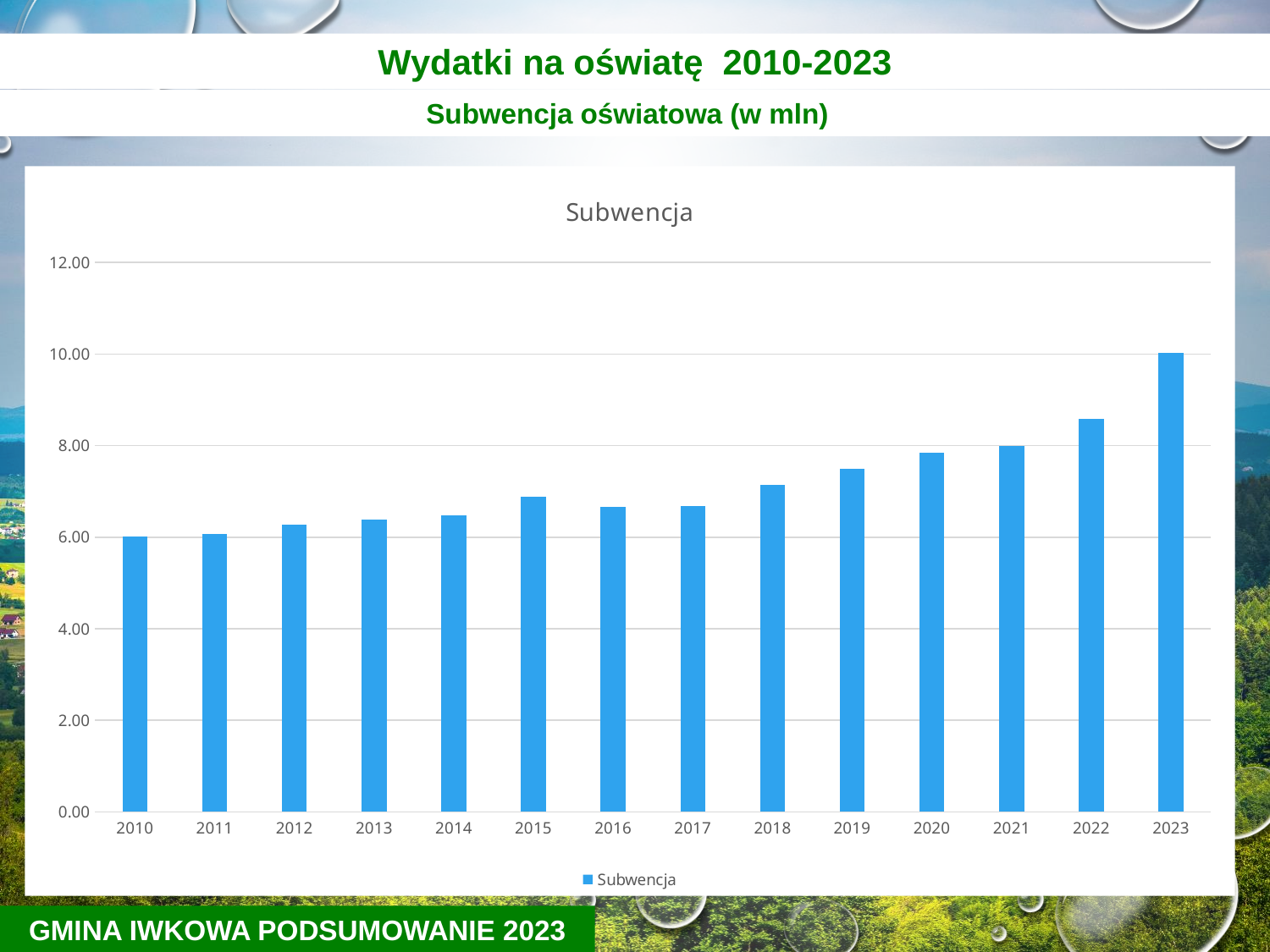
How many series does the legend list? 1 What is the title shown inside the chart area? Subwencja Which is larger, the value for 2015 or the value for 2016? 2015 Is the value for 2022 greater or less than 8.00? greater Which is larger, the value for 2021 or the value for 2022? 2022 Is the value for 2020 greater or less than 8.00? less Which year has the highest value in the chart? 2023 How many years are shown on the x axis of the chart? 14 What kind of chart is shown on the slide? bar chart Do the values generally rise or fall from 2010 to 2023? rise Is the value for 2019 greater or less than 8.00? less